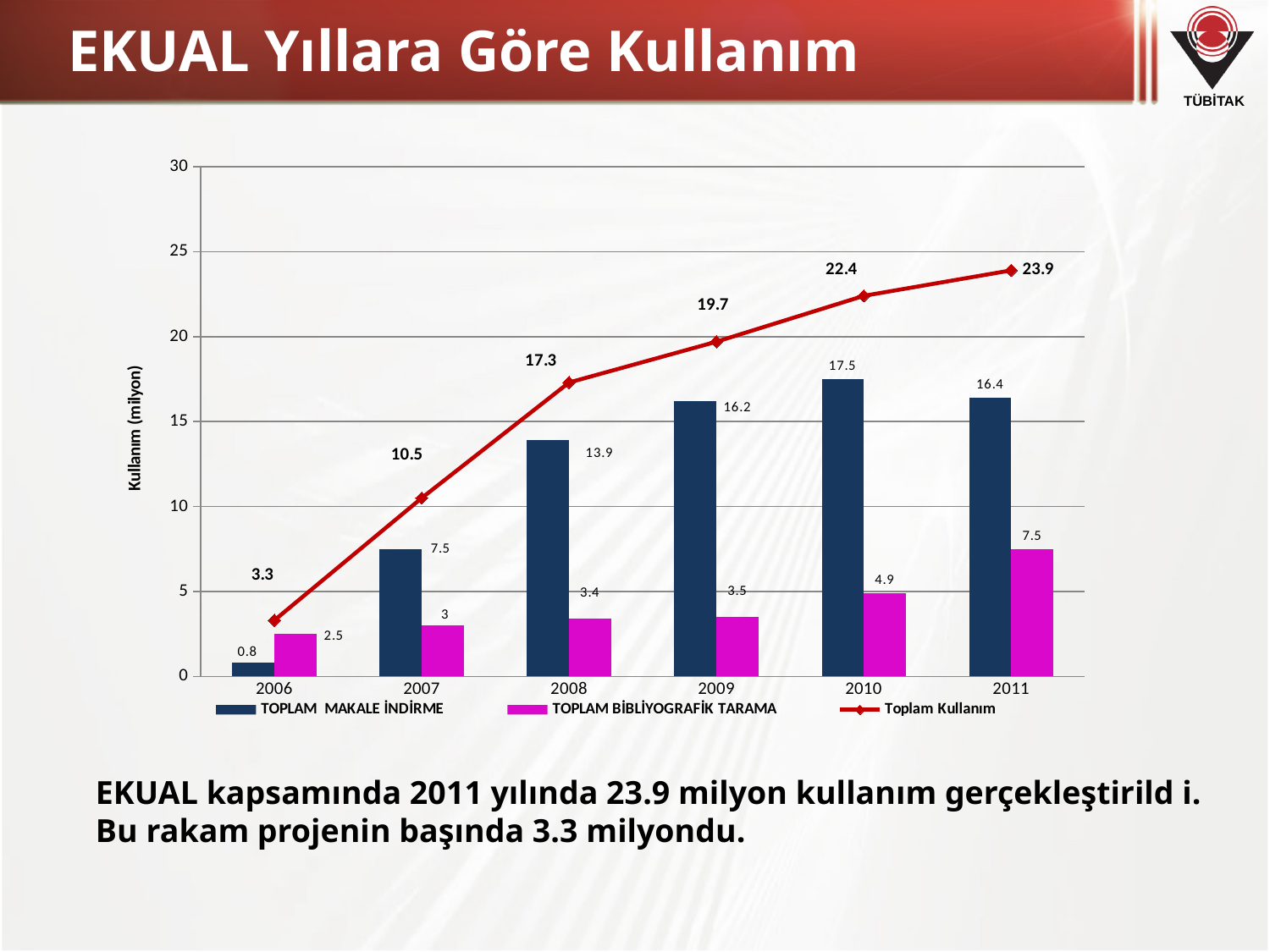
Which is larger: TOPLAM MAKALE İNDİRME in 2010 or in 2011? 2010 How many series does the legend list? 3 What is the difference between Toplam Kullanım in 2011 and in 2006? 20.6 What is the title of the slide? EKUAL Yıllara Göre Kullanım What is the value of TOPLAM BİBLİYOGRAFİK TARAMA for 2010? 4.9 How many years are shown on the x axis? 6 In which year is TOPLAM MAKALE İNDİRME lowest? 2006 What is the label of the y axis? Kullanım (milyon) In which year is Toplam Kullanım highest? 2011 What is the Toplam Kullanım value for 2009? 19.7 Does Toplam Kullanım rise or fall from 2006 to 2011? rise What is the value of TOPLAM MAKALE İNDİRME for 2008? 13.9